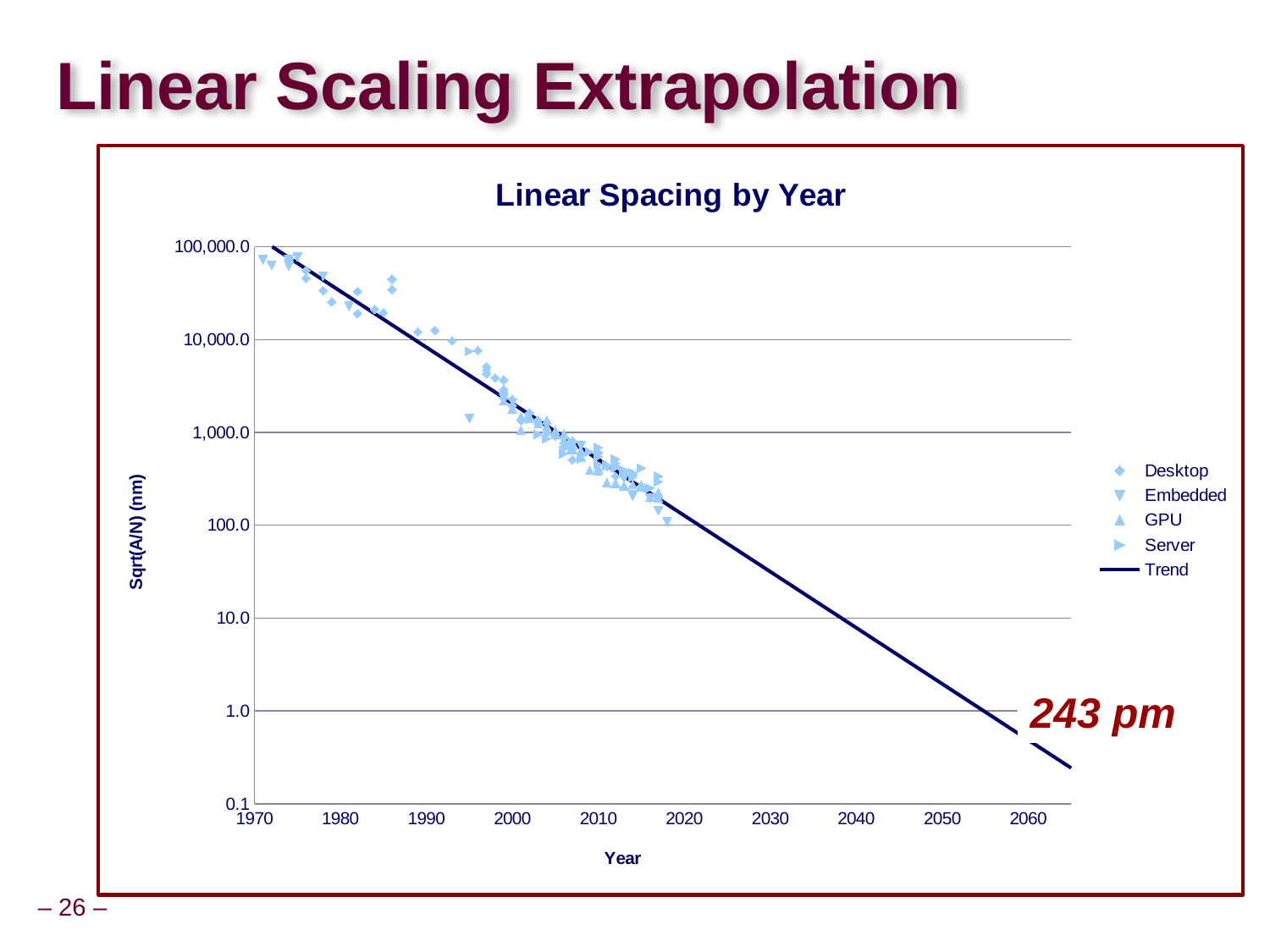
What kind of chart is shown on the slide? scatter chart with a trend line What is the label of the y axis of the chart? Sqrt(A/N) (nm) Is the value of the Trend line at 2030 greater or less than 10.0? greater Which legend entry is drawn as a solid line rather than a marker? Trend Is the value of the Trend line at 2060 greater or less than 1.0? less What is the title of the chart on the slide? Linear Spacing by Year How many series does the legend of the 'Linear Spacing by Year' chart list? 5 How many year labels are shown along the x axis of the chart? 10 Are the data points plotted around 1970 greater or less than 10,000.0? greater Do the plotted values in the 'Linear Spacing by Year' chart rise or fall as the year increases? fall